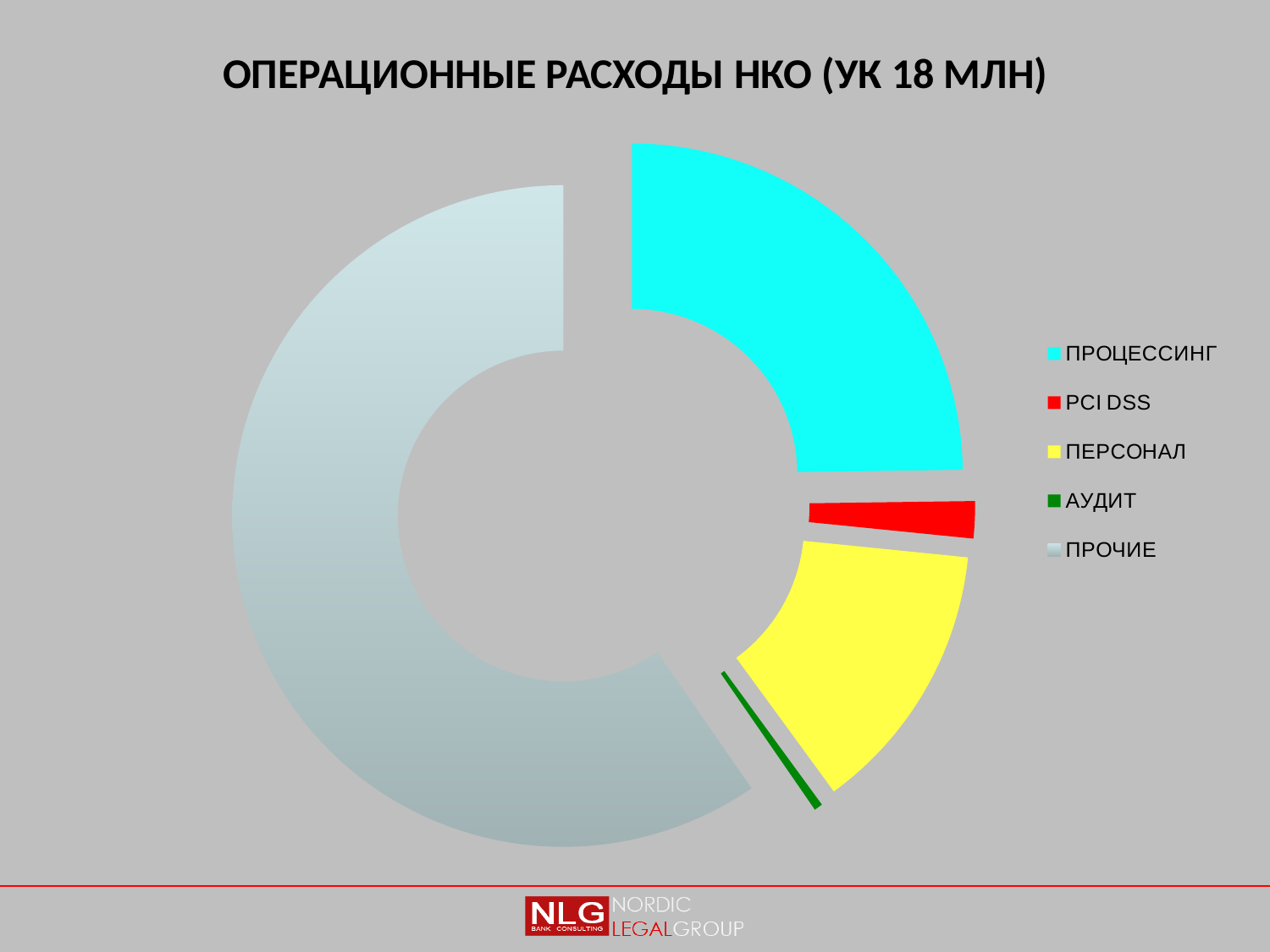
What colour is the ПЕРСОНАЛ slice? yellow Which category has the smallest slice of the chart? АУДИТ Which slice is larger, ПРОЦЕССИНГ or ПЕРСОНАЛ? ПРОЦЕССИНГ What is the title of the chart? ОПЕРАЦИОННЫЕ РАСХОДЫ НКО (УК 18 МЛН) Which slice is larger, ПРОЧИЕ or ПРОЦЕССИНГ? ПРОЧИЕ How many entries does the legend list? 5 Which category has the largest slice of the chart? ПРОЧИЕ Which slice is larger, ПЕРСОНАЛ or PCI DSS? ПЕРСОНАЛ What kind of chart is shown on the slide? doughnut chart How many categories does the chart show? 5